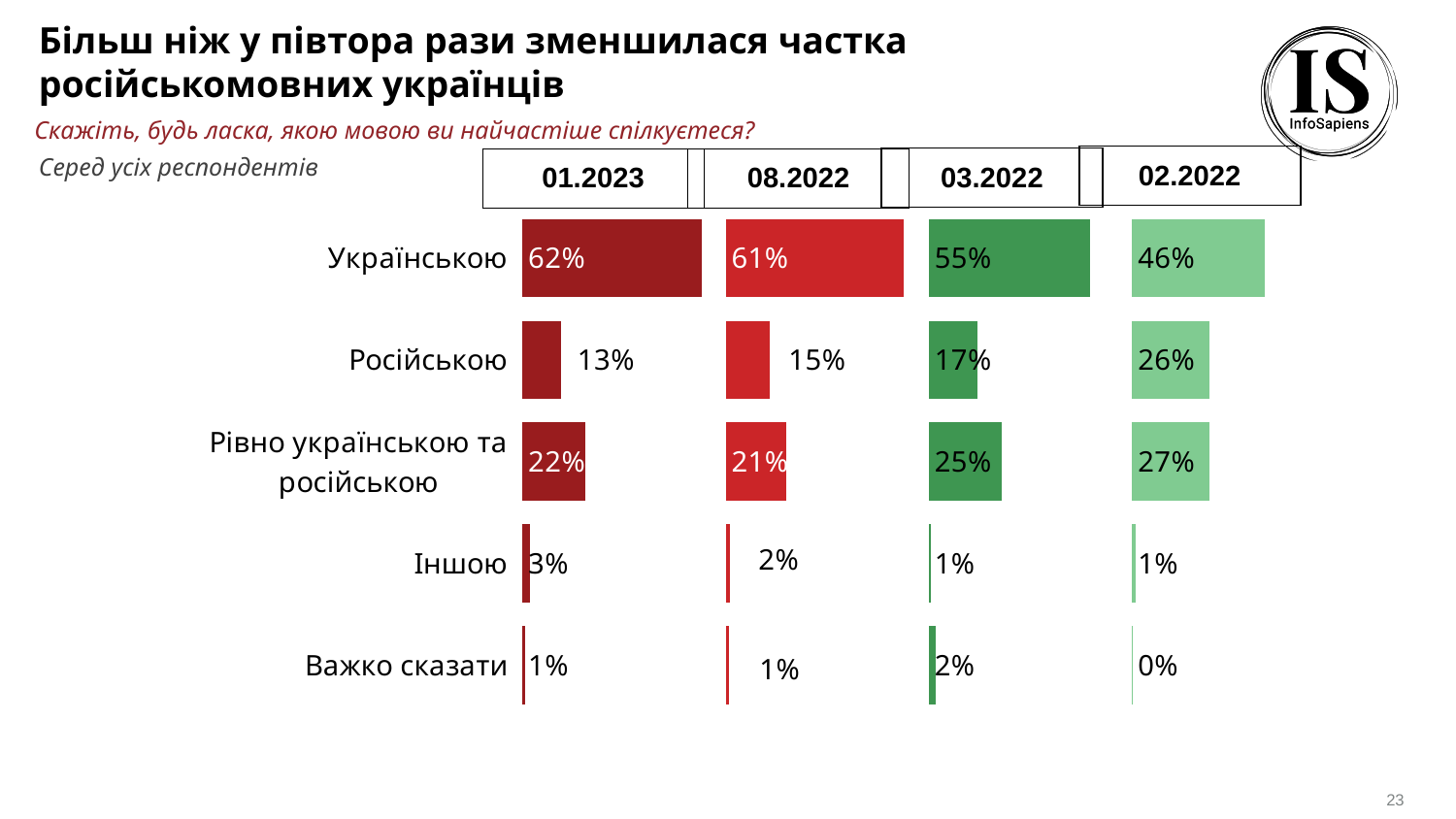
In the 08.2022 chart, what is the value for Іншою? 2% In the 03.2022 chart, what is the value for Рівно українською та російською? 25% In the 02.2022 chart, what is the value for Російською? 26% In the 01.2023 chart, what is the value for Українською? 62% What is the difference between the Російською value in the 02.2022 chart and the Російською value in the 01.2023 chart? 13% In the 03.2022 chart, which is larger: Російською or Рівно українською та російською? Рівно українською та російською How many categories are shown in each chart? 5 In the 02.2022 chart, which category has the highest value? Українською What kind of chart is used on this slide? Bar chart What is the difference between the Українською value in the 01.2023 chart and the Українською value in the 08.2022 chart? 1% Reading the Українською values from the 02.2022 chart to the 01.2023 chart, do they rise or fall? Rise In the 02.2022 chart, which category has the lowest value? Важко сказати